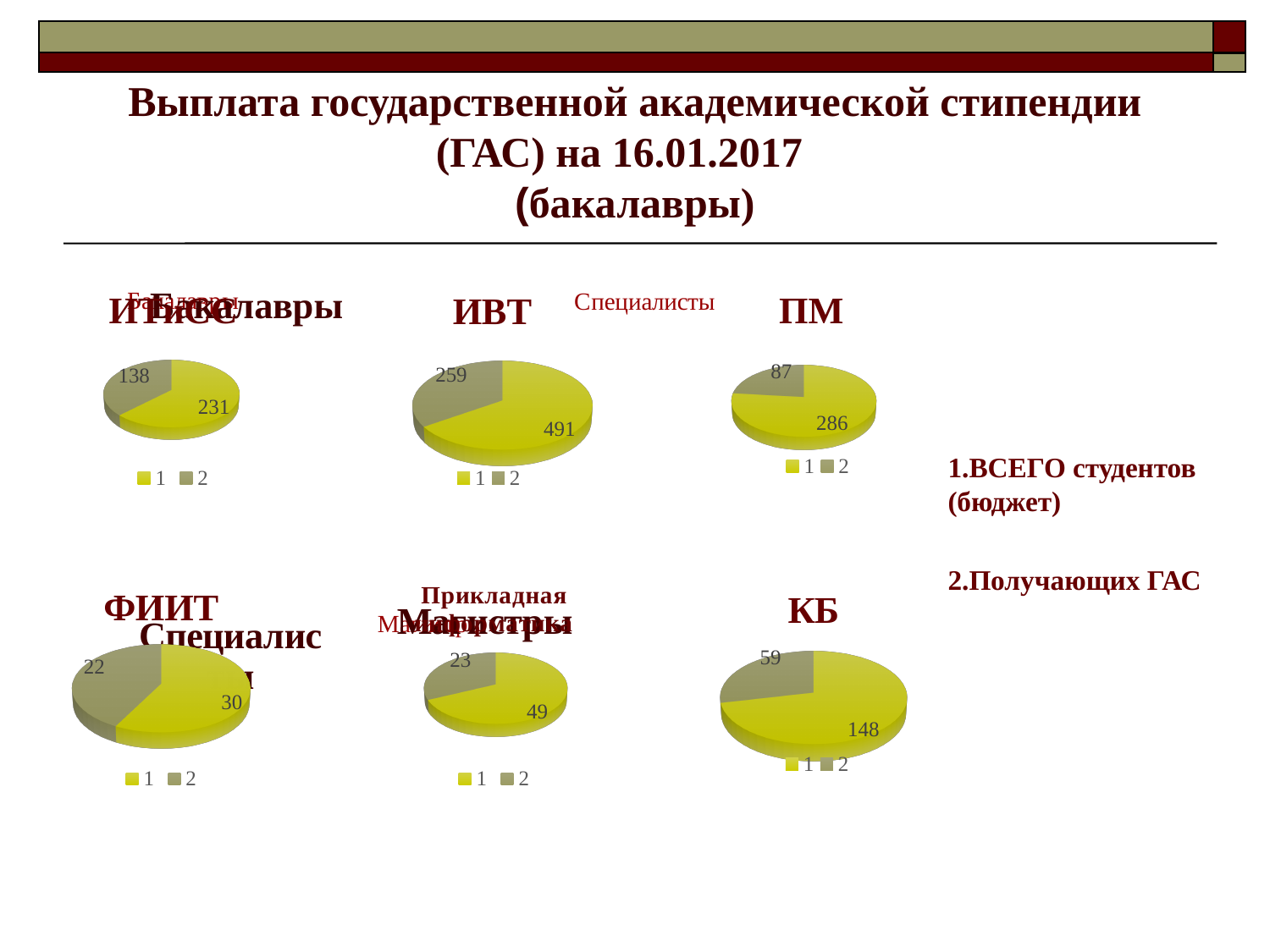
In the ПМ pie chart, what is the total of the two slices? 373 In the КБ pie chart, what is the difference between the values for series 1 and series 2? 89 In the ИВТ pie chart, what is the value for series 2? 259 In the ПМ pie chart, what is the difference between the values for series 1 and series 2? 199 How many slices does the КБ pie chart have? 2 What type of chart is used for ИВТ? pie chart In the bottom-middle pie chart (values 49 and 23), what is the total of the two slices? 72 In the ИВТ pie chart, which series has the larger value, 1 or 2? 1 How many pie charts are shown on the slide? 6 In the ИВТ pie chart, what is the value for series 1? 491 In the ПМ pie chart, what is the value for series 2? 87 In the КБ pie chart, what is the value for series 1? 148